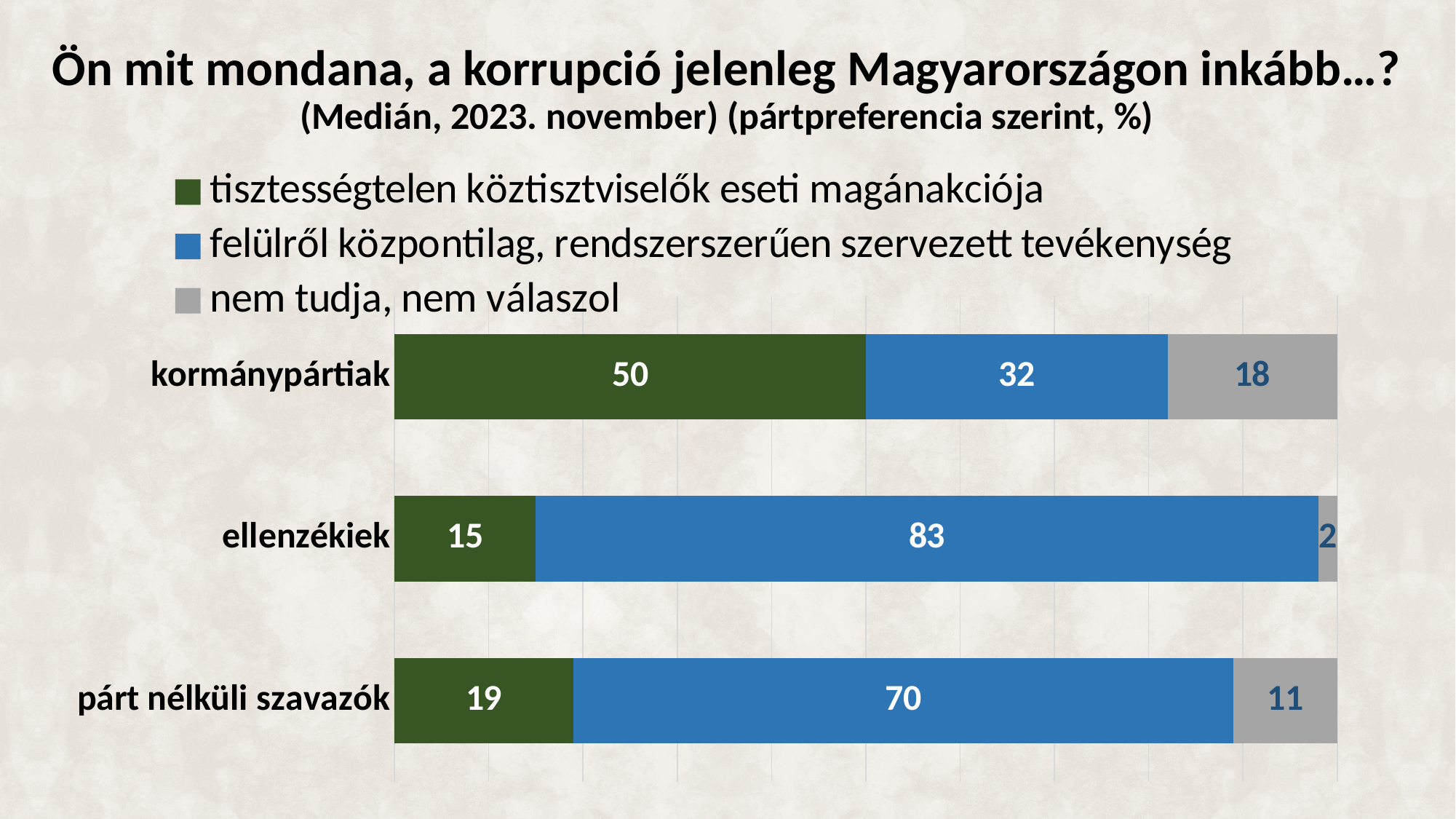
What is the difference between the 'felülről központilag, rendszerszerűen szervezett tevékenység' values for 'ellenzékiek' and 'kormánypártiak'? 51 What is the total of the stacked bar for 'párt nélküli szavazók'? 100 Which is larger: the 'tisztességtelen köztisztviselők eseti magánakciója' value for 'párt nélküli szavazók' or for 'ellenzékiek'? párt nélküli szavazók How many series does the legend list? 3 What is the value for 'párt nélküli szavazók' in the 'nem tudja, nem válaszol' series? 11 What is the value for 'kormánypártiak' in the 'tisztességtelen köztisztviselők eseti magánakciója' series? 50 Which category has the lowest value in the 'tisztességtelen köztisztviselők eseti magánakciója' series? ellenzékiek Which category has the highest value in the 'felülről központilag, rendszerszerűen szervezett tevékenység' series? ellenzékiek What is the value for 'kormánypártiak' in the 'nem tudja, nem válaszol' series? 18 What kind of chart is shown on the slide? stacked bar chart How many categories are shown on the chart? 3 What is the value for 'ellenzékiek' in the 'felülről központilag, rendszerszerűen szervezett tevékenység' series? 83